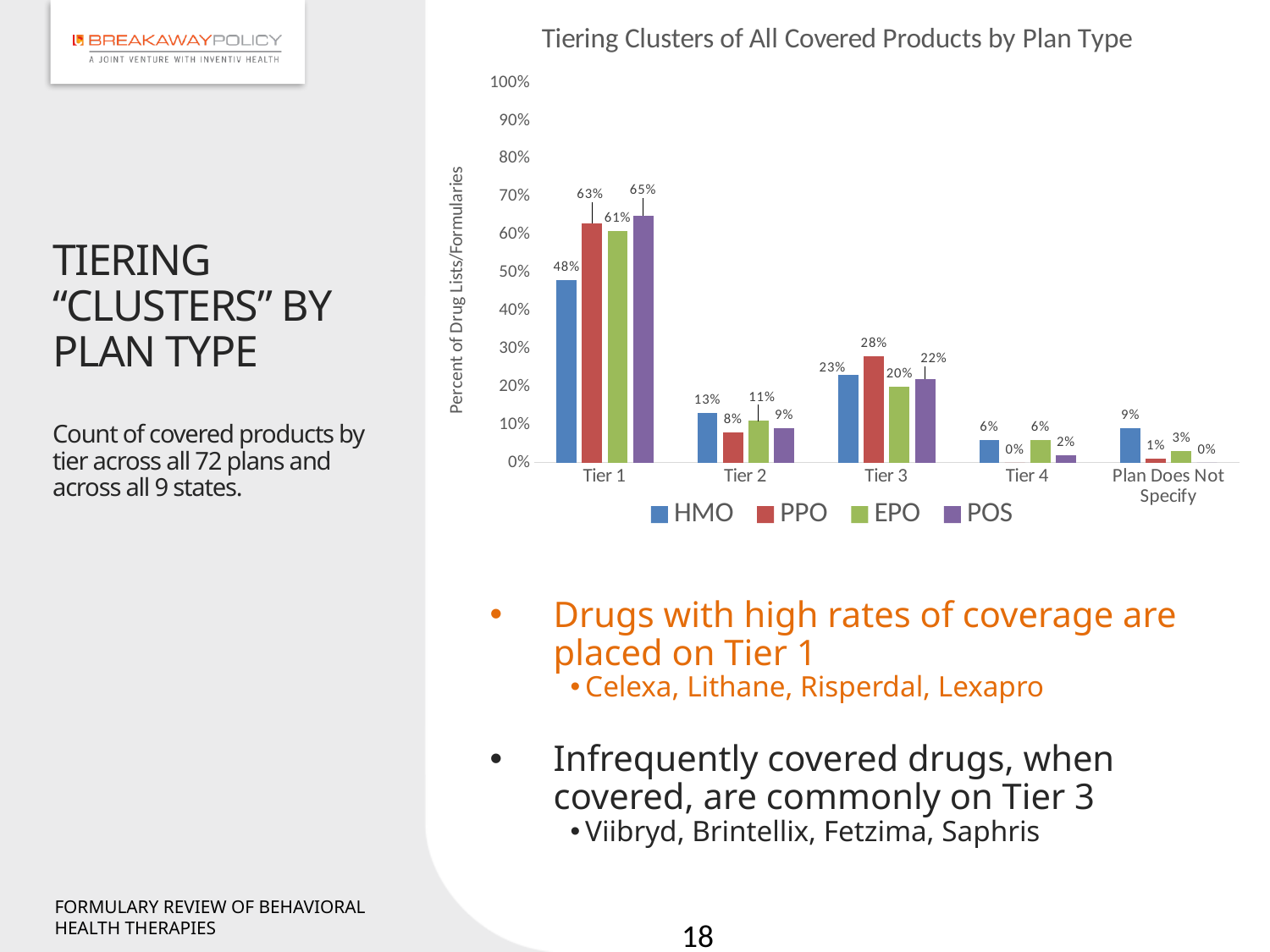
What is the title of the chart? Tiering Clusters of All Covered Products by Plan Type Which plan type has the highest value for Tier 1? POS What is the HMO value for Tier 1? 48% What is the EPO value for Tier 2? 11% What is the PPO value for Tier 3? 28% What is the POS value for Tier 1? 65% How many series does the legend list? 4 What is the difference between the PPO and HMO values for Tier 1? 15% What kind of chart is shown? Bar chart Which is larger for Tier 2, the HMO value or the PPO value? HMO Which plan type has the lowest value for Tier 1? HMO How many tier categories are shown on the x axis? 5